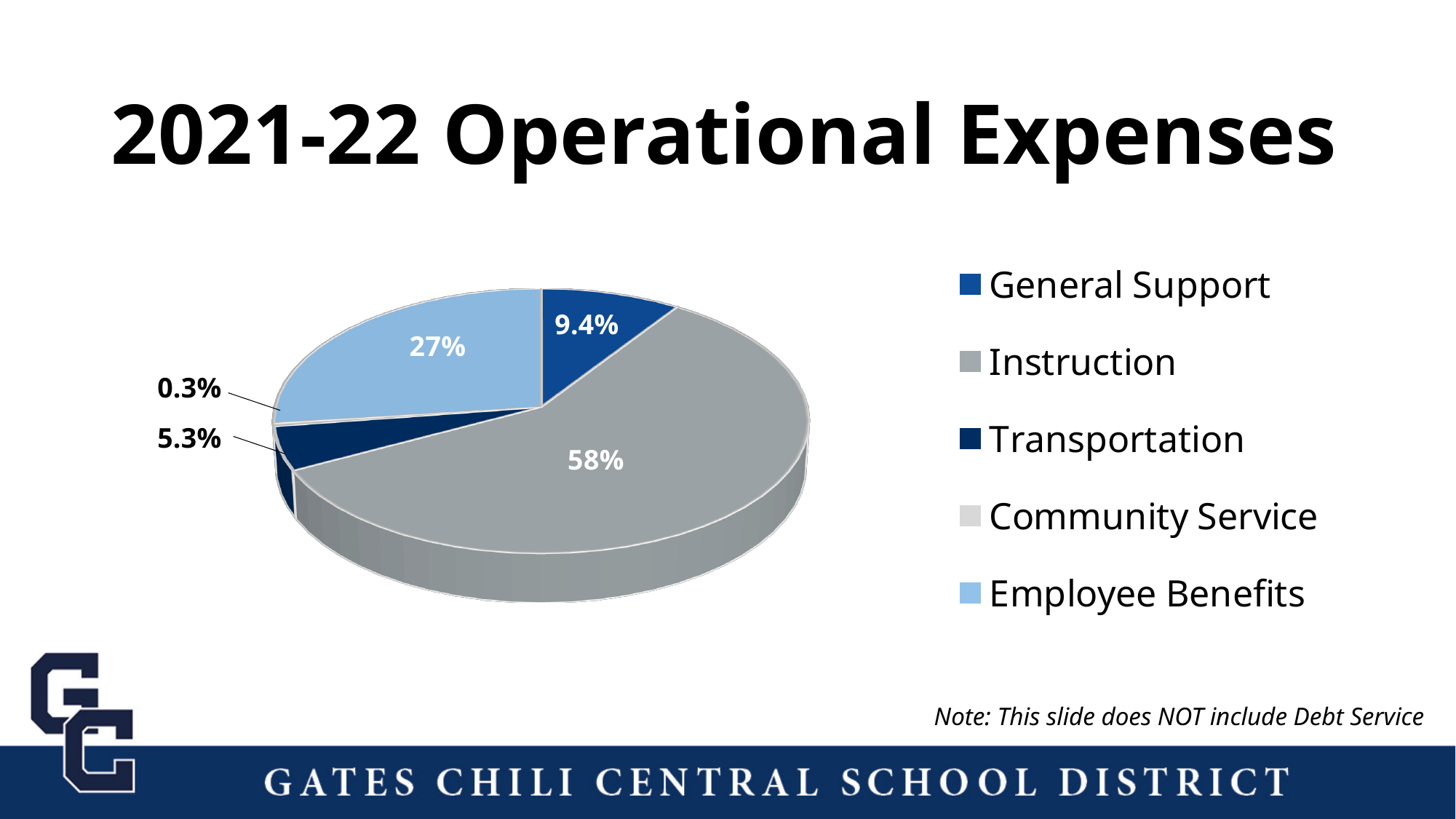
Which category has the smallest share of operational expenses? Community Service What kind of chart is shown on the slide? pie chart What is the difference in percentage points between the Instruction share and the Employee Benefits share? 31 What share of operational expenses is Transportation? 5.3% What share of operational expenses is Instruction? 58% What is the title of the chart slide? 2021-22 Operational Expenses How many categories does the legend list? 5 What share of operational expenses is Employee Benefits? 27% What share of operational expenses is Community Service? 0.3% Which is larger, the share for Employee Benefits or the share for General Support? Employee Benefits What share of operational expenses is General Support? 9.4% Which category has the largest share of operational expenses? Instruction